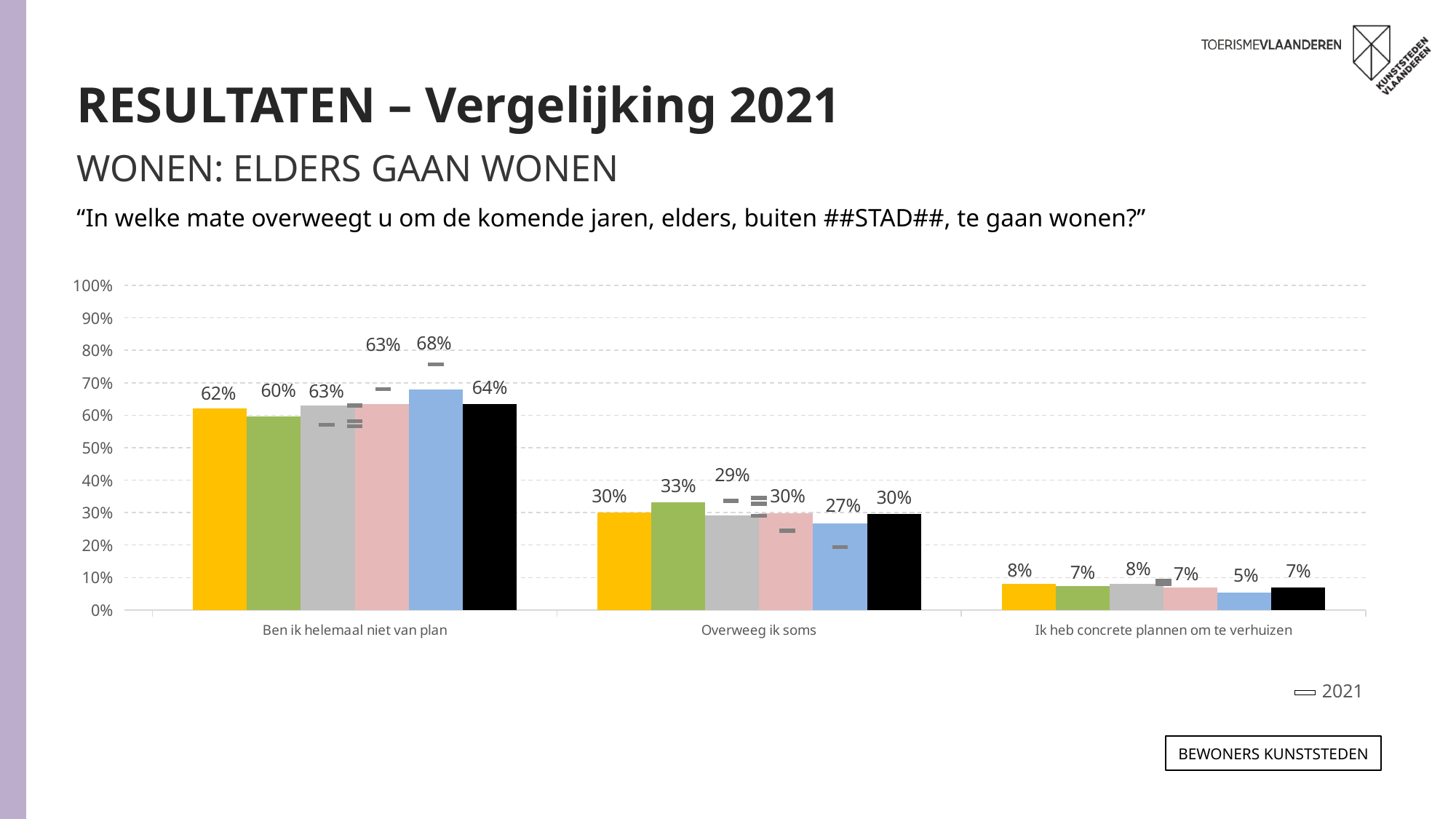
What is the value of the yellow bar for 'Ben ik helemaal niet van plan'? 62% What is the value of the green bar for 'Overweeg ik soms'? 33% What is the difference between the blue bar and the green bar in the 'Ben ik helemaal niet van plan' category? 8 percentage points What entry does the chart legend list? 2021 Is the value of the black bar for 'Ben ik helemaal niet van plan' greater or less than 50%? greater How many categories are shown on the x axis of the chart? 3 What is the value of the blue bar for 'Ik heb concrete plannen om te verhuizen'? 5% In the 'Overweeg ik soms' category, which is larger: the green bar or the blue bar? green bar Which coloured bar is the lowest in the 'Overweeg ik soms' category? blue Which coloured bar is the highest in the 'Ben ik helemaal niet van plan' category? blue What is the value of the blue bar for 'Ben ik helemaal niet van plan'? 68% What kind of chart is shown on the slide? bar chart